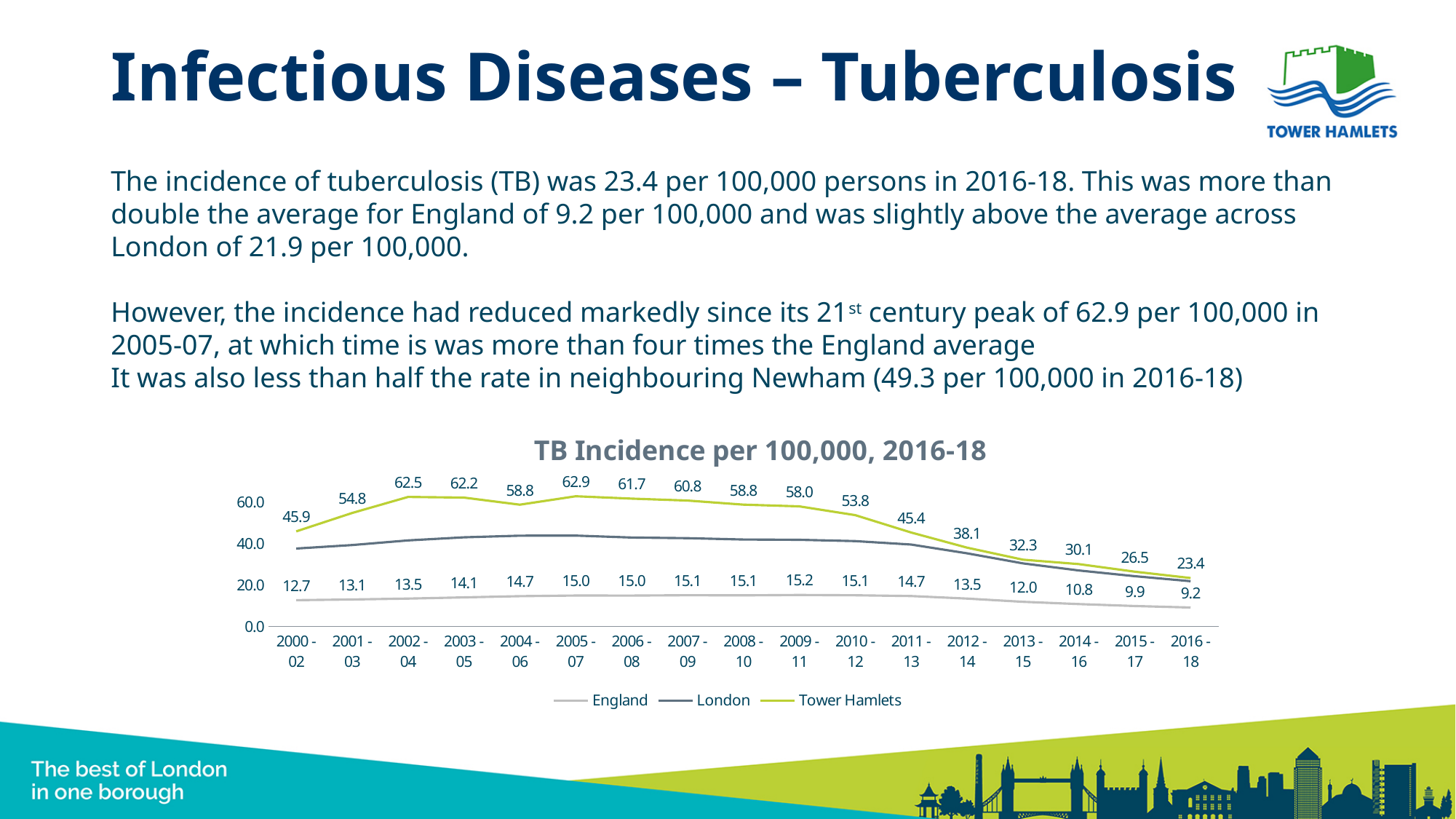
What is the TB incidence for England in 2016-18? 9.2 What is the TB incidence for Tower Hamlets in 2005-07? 62.9 How many series does the legend list? 3 In which period is the Tower Hamlets TB incidence highest? 2005-07 What is the difference between the Tower Hamlets TB incidence in 2000-02 and in 2016-18? 22.5 What is the TB incidence for Tower Hamlets in 2000-02? 45.9 What type of chart is shown on the slide? Line chart In which period is the Tower Hamlets TB incidence lowest? 2016-18 In which period is the England TB incidence highest? 2009-11 How many time periods are plotted along the x axis? 17 Does the Tower Hamlets TB incidence rise or fall from 2010-12 to 2016-18? Fall Is the London TB incidence in 2005-07 greater or less than 40.0? greater